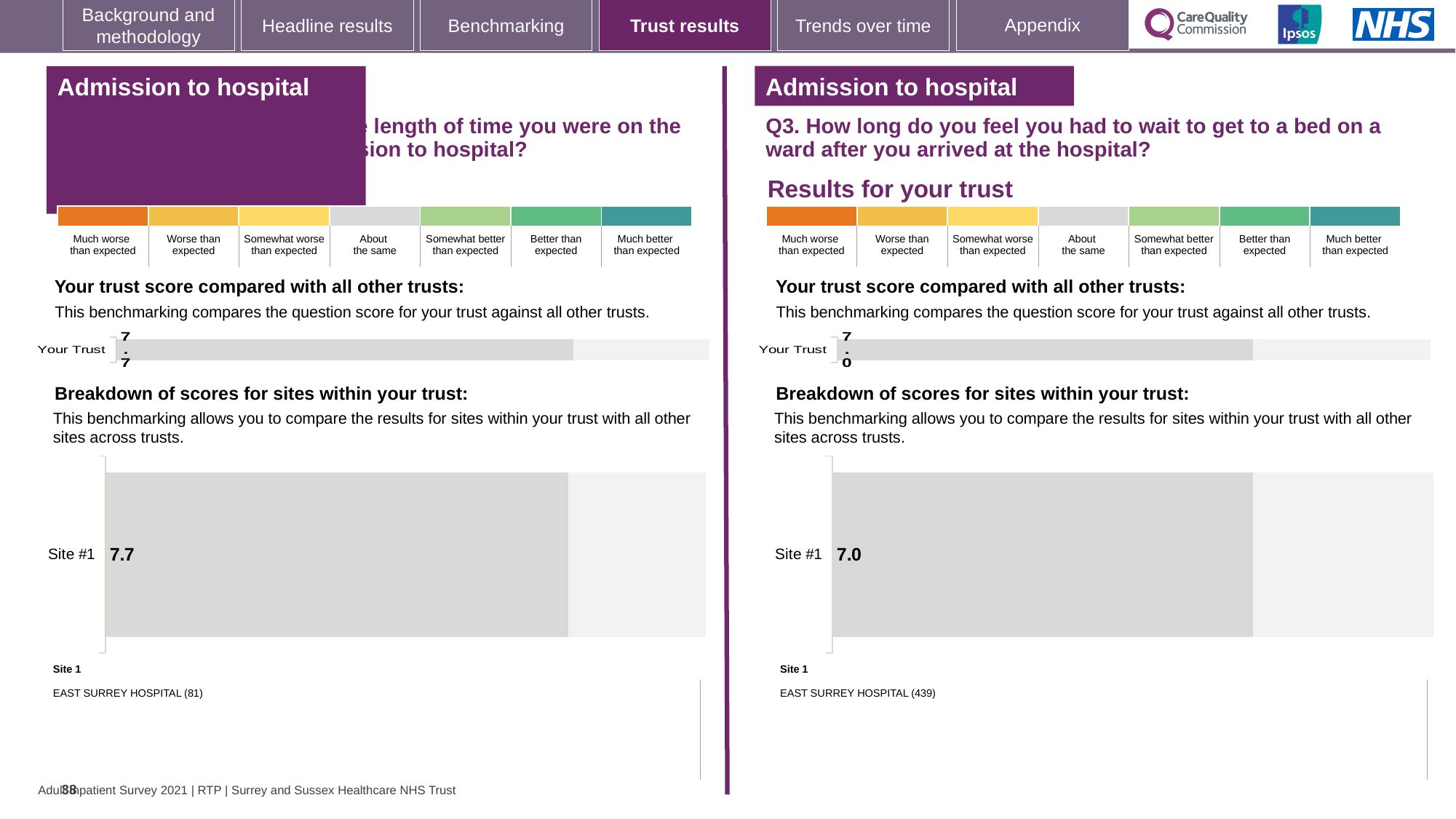
On the right half of the slide (Q3), which hospital is listed as Site 1 below the breakdown chart? EAST SURREY HOSPITAL (439) What is the difference between the Site #1 score on the left half of the slide and the Site #1 score on the right half (Q3)? 0.7 On the left half of the slide, which hospital is listed as Site 1 below the breakdown chart? EAST SURREY HOSPITAL (81) How many categories are shown in the colour scale legend above the trust score comparison on the right half of the slide? 7 Which Site #1 score is larger: the one on the left half of the slide or the one on the right half (Q3)? Left half (7.7) On the left half of the slide, what is the score shown for Site #1 in the breakdown of scores for sites within your trust? 7.7 On the left half of the slide, what is the 'Your Trust' score in the trust score comparison chart? 7.7 On the right half of the slide (Q3), what is the 'Your Trust' score in the trust score comparison chart? 7.0 On the right half of the slide (Q3), what is the score shown for Site #1 in the breakdown of scores for sites within your trust? 7.0 How many sites are shown in the breakdown of scores chart on the right half of the slide (Q3)? 1 What type of chart is used to show the Site #1 score on the left half of the slide? Bar chart